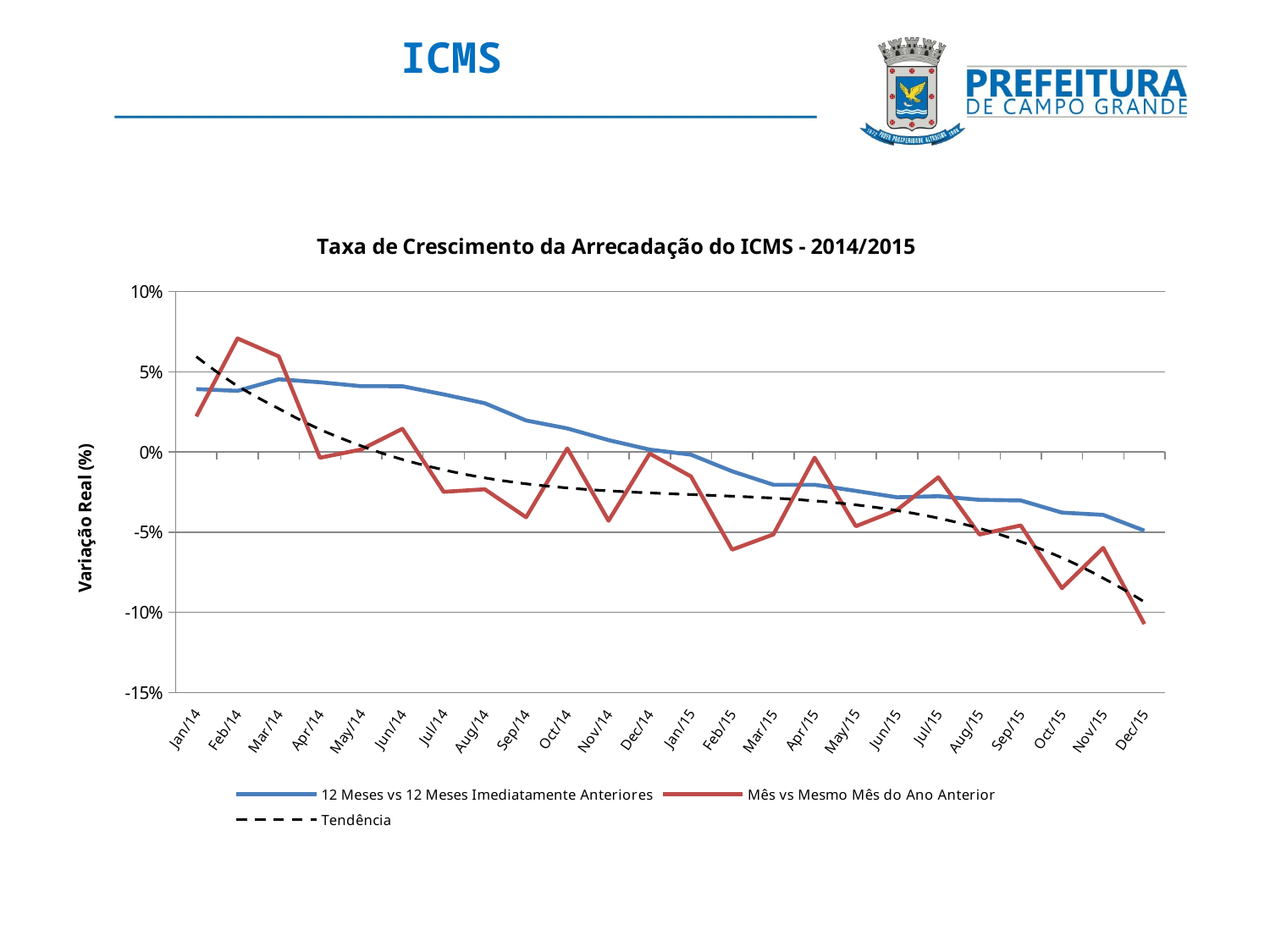
How many months are plotted along the x axis? 24 In which month does the '12 Meses vs 12 Meses Imediatamente Anteriores' series reach its lowest value? Dec/15 Which is larger for the 'Mês vs Mesmo Mês do Ano Anterior' series: the value for Feb/14 or the value for Oct/15? Feb/14 What is the title of the chart? Taxa de Crescimento da Arrecadação do ICMS - 2014/2015 Is the value of 'Mês vs Mesmo Mês do Ano Anterior' for Feb/14 greater or less than 5%? greater Does the '12 Meses vs 12 Meses Imediatamente Anteriores' series generally rise or fall from Jan/14 to Dec/15? fall Is the value of 'Mês vs Mesmo Mês do Ano Anterior' for Oct/15 greater or less than -5%? less Is the value of 'Mês vs Mesmo Mês do Ano Anterior' for Dec/15 greater or less than -10%? less How many series does the legend list? 3 What kind of chart is shown on the slide? line chart In which month does the 'Mês vs Mesmo Mês do Ano Anterior' series reach its highest value? Feb/14 In which month does the 'Mês vs Mesmo Mês do Ano Anterior' series reach its lowest value? Dec/15